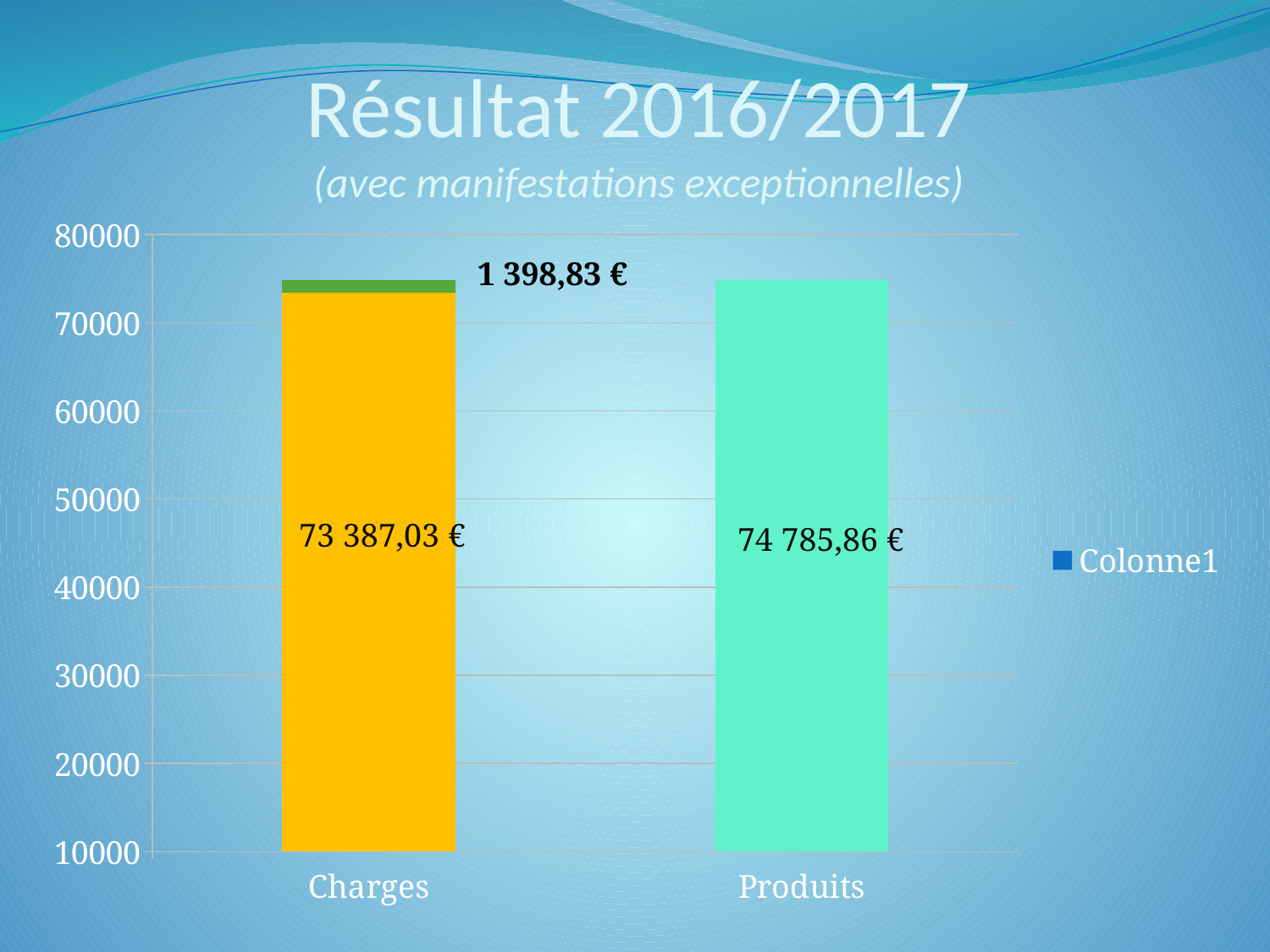
What is the title of the slide? Résultat 2016/2017 What is the value printed on the orange segment of the Charges bar? 73 387,03 € Which is larger: the orange Charges segment or the Produits value? Produits What is the value printed for Produits? 74 785,86 € What kind of chart is shown on the slide? Bar chart How many entries does the legend list? 1 What value is printed next to the green segment at the top of the Charges bar? 1 398,83 € What is the difference between the Produits value and the orange Charges segment value? 1 398,83 € How many categories are shown on the x axis? 2 Is the value for Produits greater or less than 70000? greater Which printed value on the chart is the smallest? 1 398,83 € What is the total of the stacked Charges bar (orange plus green segments)? 74 785,86 €